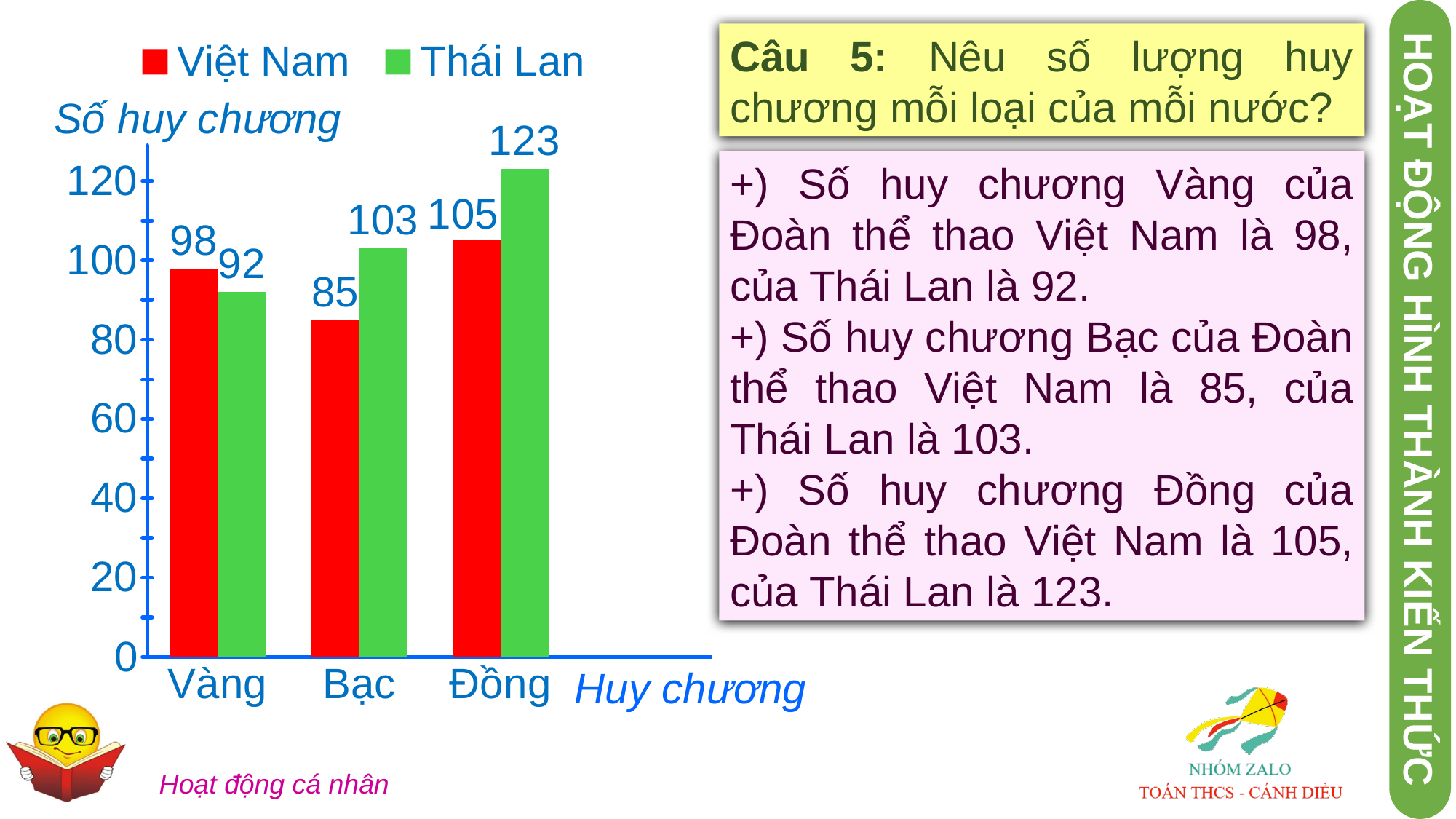
What kind of chart is shown on the slide? bar chart What is the value for Việt Nam in the Vàng category? 98 How many categories are shown on the x axis? 3 Which category has the highest value for Việt Nam? Đồng What is the difference between Thái Lan and Việt Nam in the Bạc category? 18 What is the label of the vertical axis? Số huy chương How many series does the legend list? 2 Is the value for Thái Lan in the Đồng category greater or less than 120? greater What is the value for Thái Lan in the Bạc category? 103 Which is larger in the Vàng category, Việt Nam or Thái Lan? Việt Nam Which category has the lowest value for Thái Lan? Vàng What is the value for Thái Lan in the Đồng category? 123